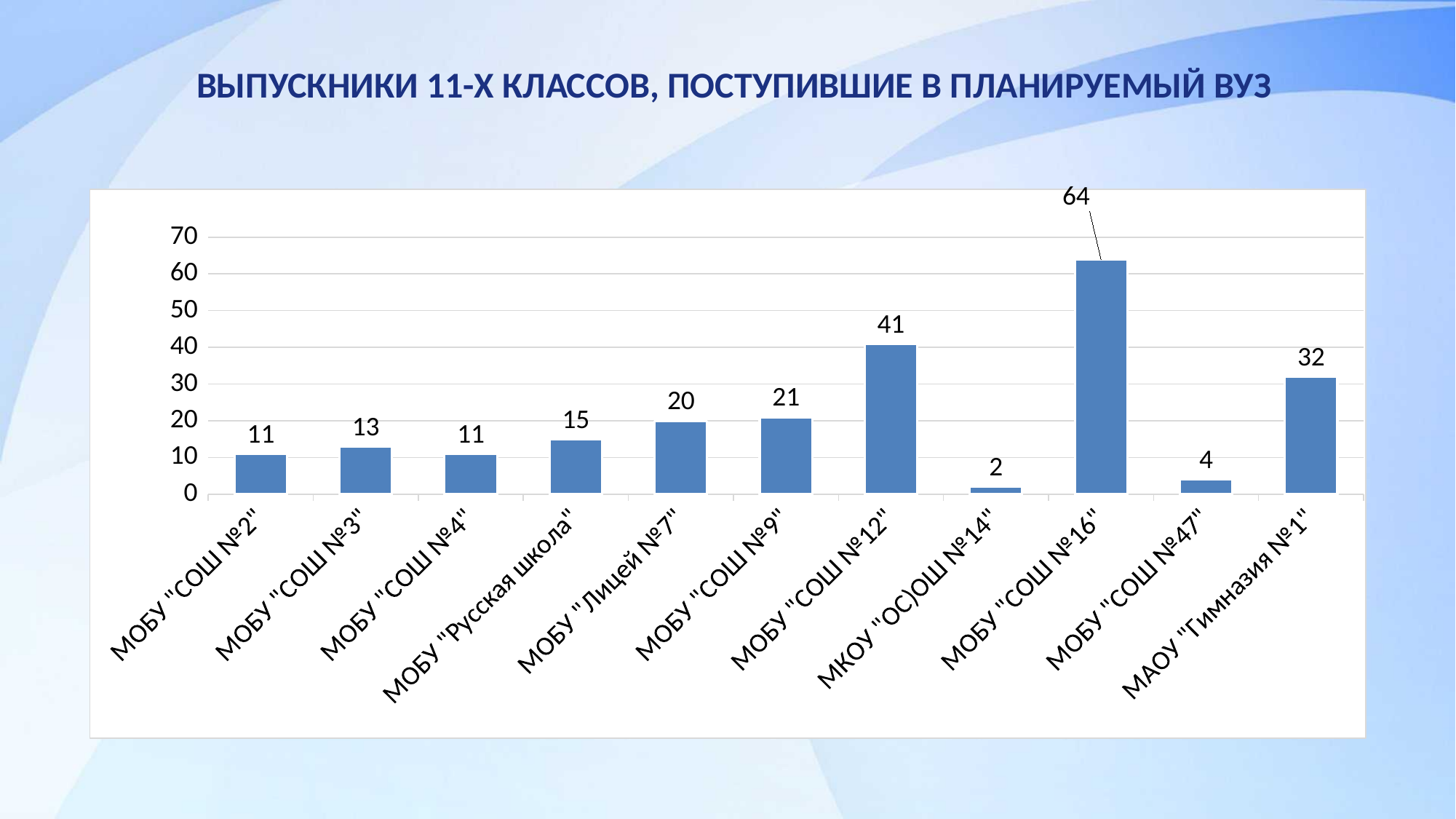
What is the title of the slide? ВЫПУСКНИКИ 11-Х КЛАССОВ, ПОСТУПИВШИЕ В ПЛАНИРУЕМЫЙ ВУЗ What is the value for МОБУ "Русская школа"? 15 Which category has the highest value? МОБУ "СОШ №16" What is the value for МАОУ "Гимназия №1"? 32 Which category has the lowest value? МКОУ "ОС)ОШ №14" What is the value for МОБУ "СОШ №16"? 64 What kind of chart is shown on the slide? bar chart What is the difference between the values for МОБУ "СОШ №16" and МОБУ "СОШ №12"? 23 Which is larger, the value for МОБУ "СОШ №9" or the value for МОБУ "Лицей №7"? МОБУ "СОШ №9" What is the difference between the values for МОБУ "СОШ №3" and МОБУ "СОШ №47"? 9 Is the value for МОБУ "СОШ №12" greater or less than 30? greater How many categories are shown on the x axis? 11